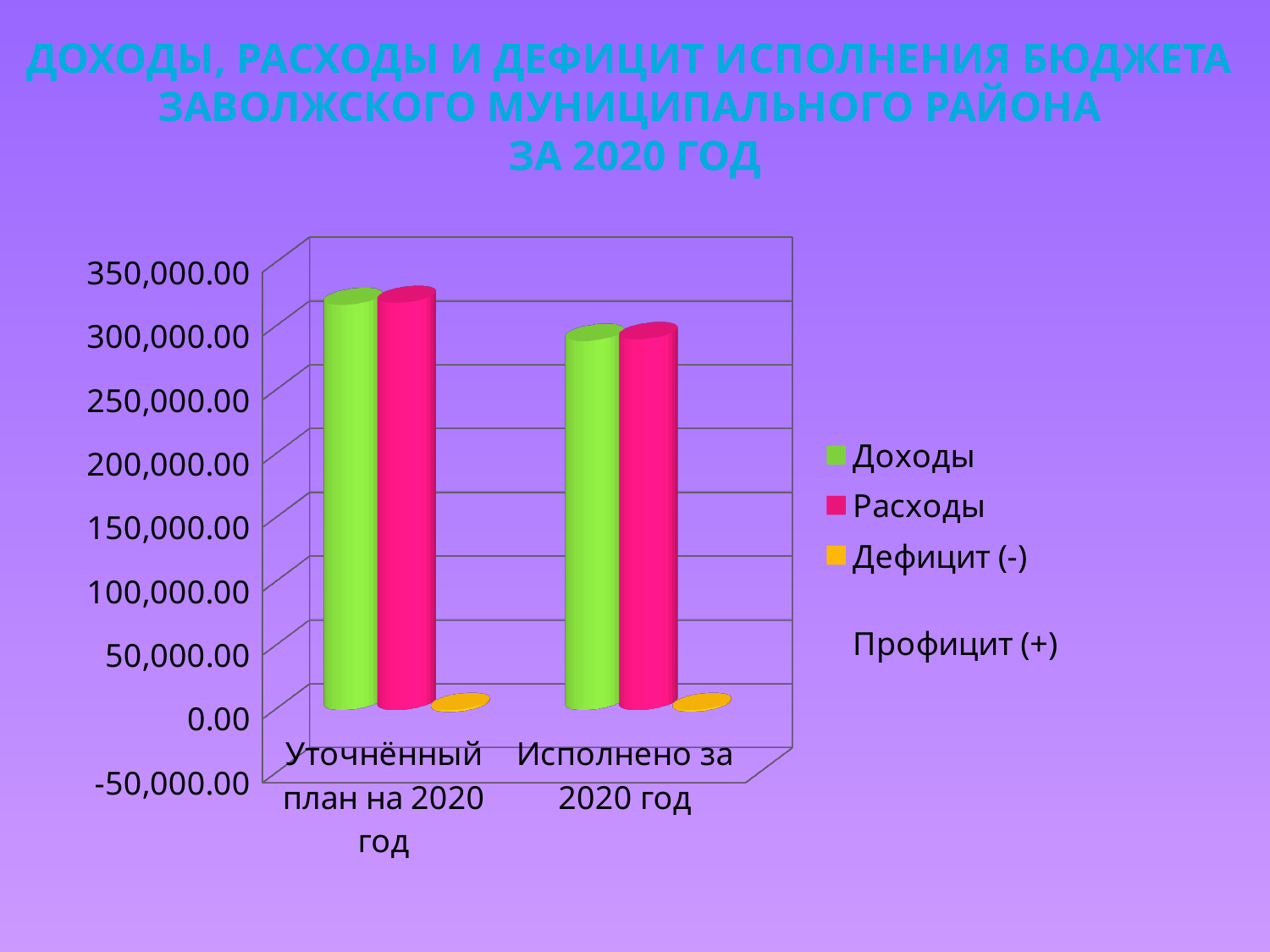
Which series has the lowest value for Исполнено за 2020 год? Дефицит (-) Профицит (+) What kind of chart is shown on the slide? bar chart Is the value of Доходы for Исполнено за 2020 год greater or less than 250,000.00? greater What colour are the Расходы bars in the chart? pink How many series does the chart legend list? 3 How many categories are shown on the x axis of the chart? 2 Which is larger: Расходы for Уточнённый план на 2020 год or Расходы for Исполнено за 2020 год? Уточнённый план на 2020 год Do the Доходы values rise or fall from Уточнённый план на 2020 год to Исполнено за 2020 год? fall Is the value of Расходы for Уточнённый план на 2020 год greater or less than 300,000.00? greater Is the value of Расходы for Исполнено за 2020 год greater or less than 350,000.00? less Which is larger: Доходы for Уточнённый план на 2020 год or Доходы for Исполнено за 2020 год? Уточнённый план на 2020 год